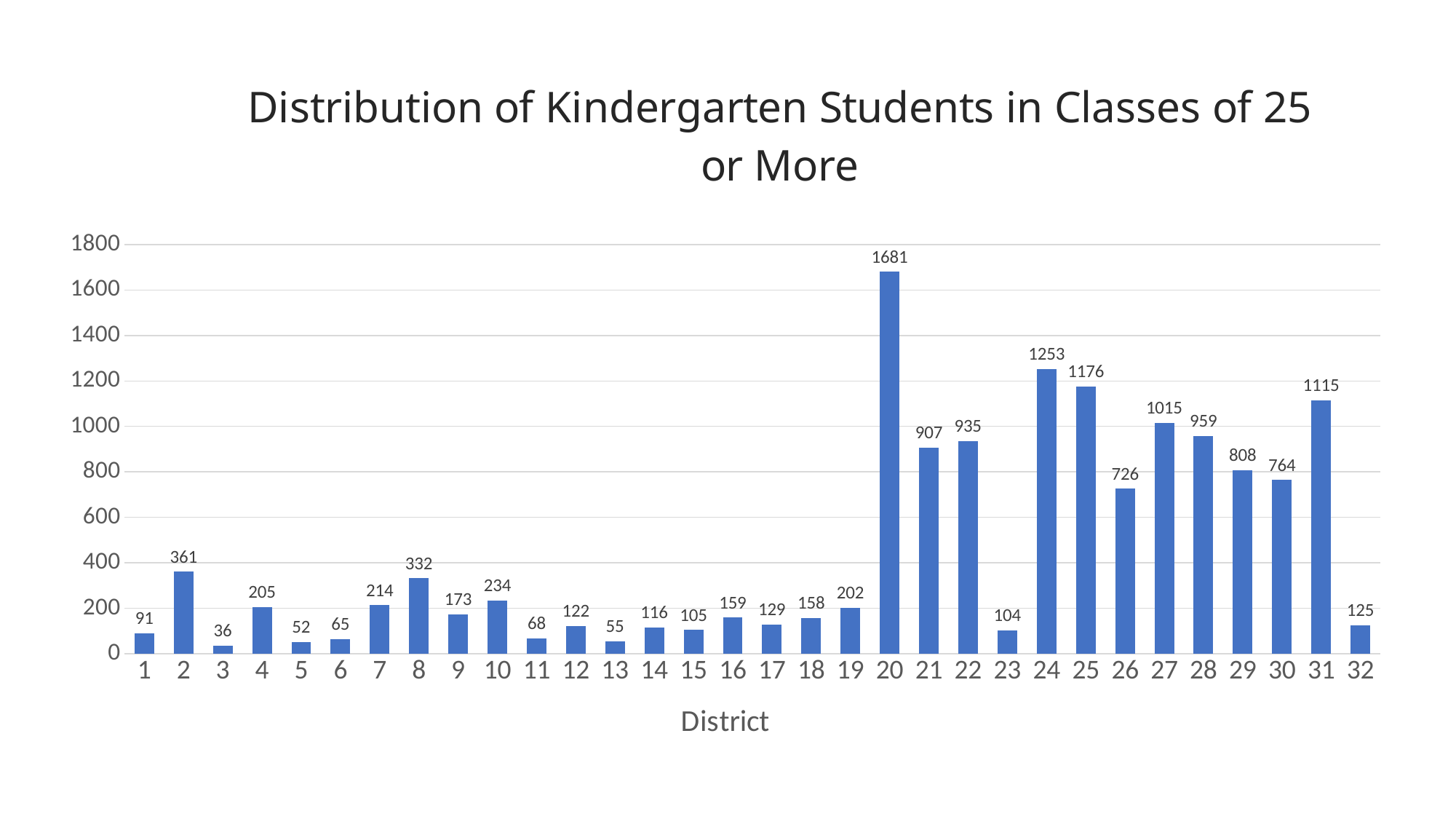
What is the value for District 26? 726 What is the difference between the values for District 24 and District 25? 77 What is the value for District 20? 1681 Which is larger, the value for District 21 or District 22? District 22 Which district has the lowest value? 3 What is the title of the chart? Distribution of Kindergarten Students in Classes of 25 or More Is the value for District 31 greater or less than 1000? greater What is the value for District 8? 332 Which district has the highest value? 20 What is the label of the x axis? District How many districts are shown on the x axis? 32 What kind of chart is this? Bar chart